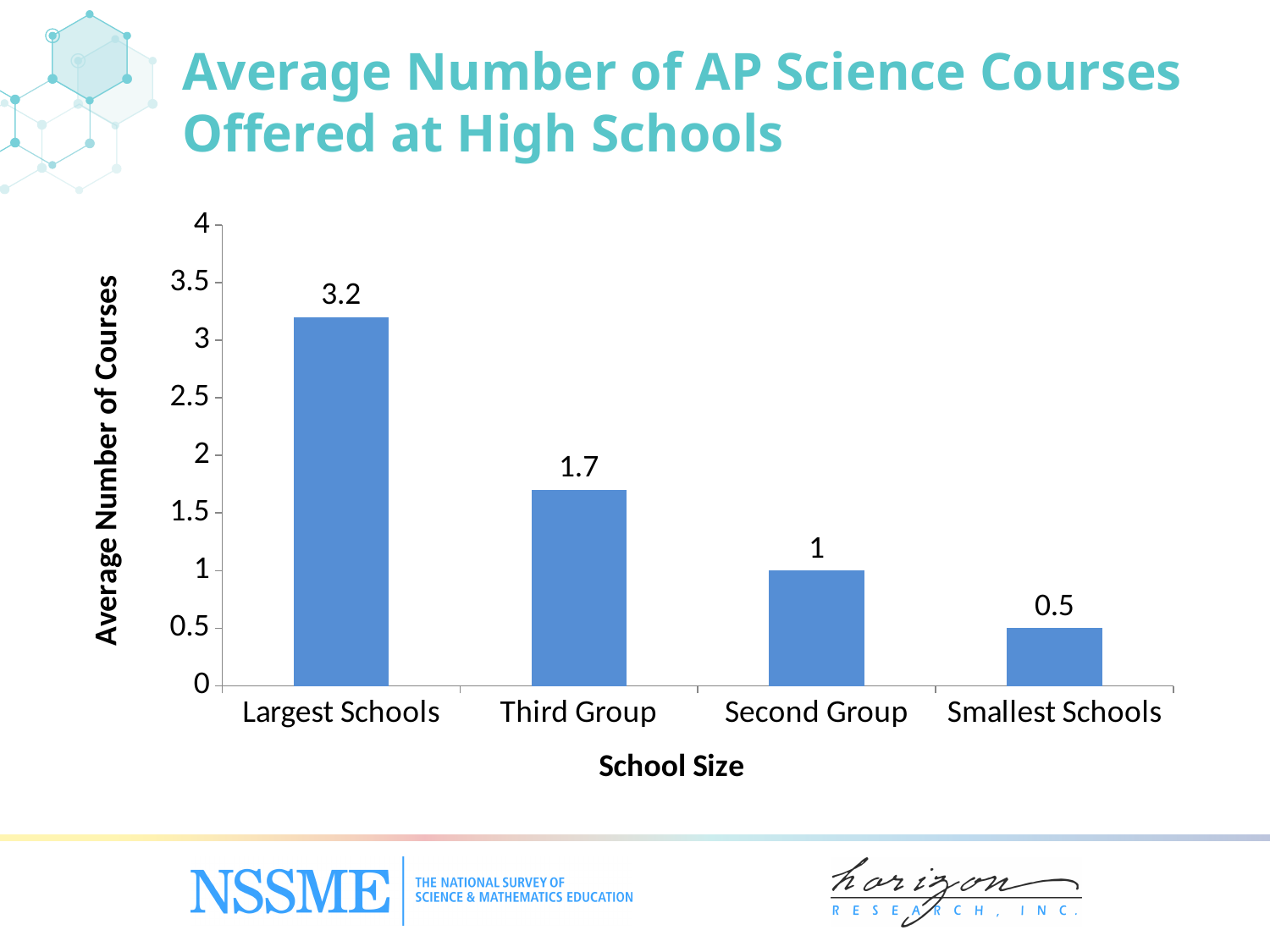
Which has a larger value, Third Group or Second Group? Third Group Do the values rise or fall moving from left to right along the x axis? Fall What is the difference between the values for Third Group and Second Group? 0.7 What is the value shown for the Third Group? 1.7 What is the average number of AP science courses offered at the Largest Schools? 3.2 What kind of chart is shown on the slide? Bar chart Which school size category has the lowest average number of AP science courses? Smallest Schools What is the value shown for the Second Group? 1 How many school size categories are shown on the chart? 4 What is the difference between the values for Largest Schools and Smallest Schools? 2.7 Which school size category has the highest average number of AP science courses? Largest Schools What is the average number of AP science courses offered at Smallest Schools? 0.5